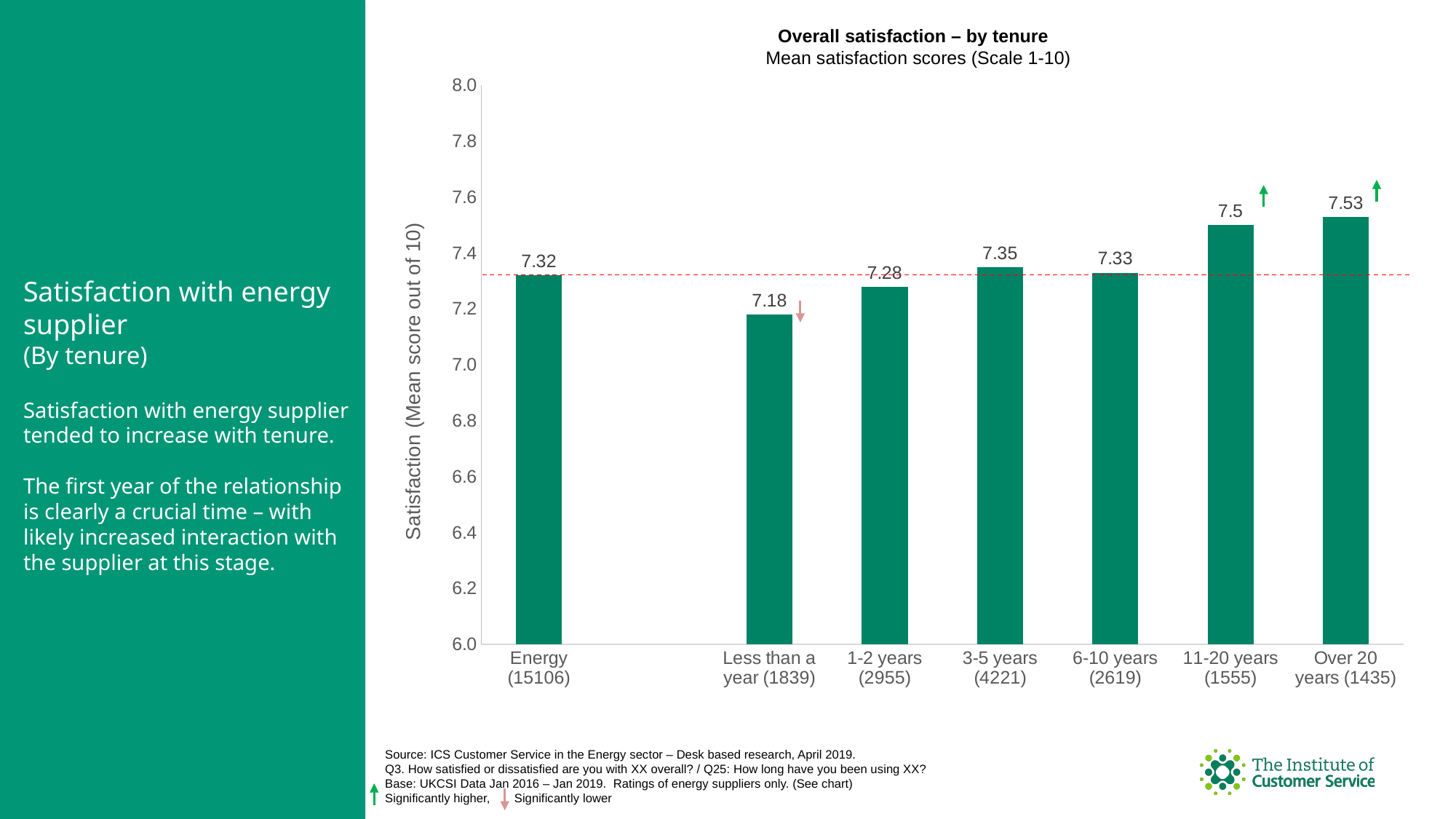
What is the mean satisfaction score for customers with tenure of less than a year? 7.18 Which tenure group has the highest mean satisfaction score? Over 20 years Which has a higher mean satisfaction score, 1-2 years or 6-10 years? 6-10 years What is the mean satisfaction score for the 3-5 years tenure group? 7.35 What is the mean satisfaction score for the Over 20 years tenure group? 7.53 Is the value for 11-20 years greater or less than 7.4? greater What is the title of the chart? Overall satisfaction – by tenure What is the difference between the mean satisfaction scores for Over 20 years and Less than a year? 0.35 How many bars are shown in the chart? 7 Which category has the lowest mean satisfaction score? Less than a year What is the mean satisfaction score for Energy (15106)? 7.32 What type of chart is shown on the slide? Bar chart